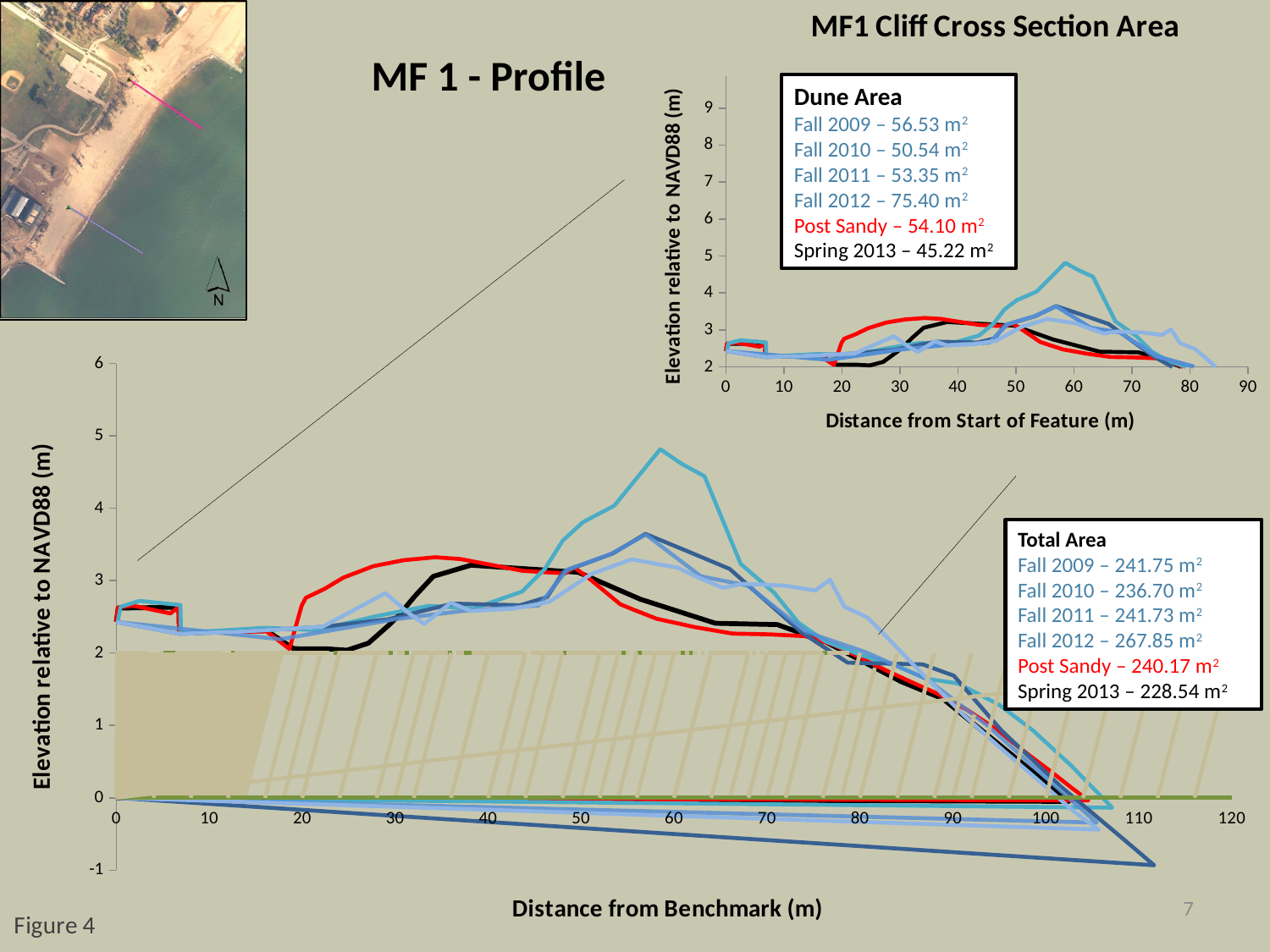
In the Dune Area box on the MF1 Cliff Cross Section Area chart, what is the value for Fall 2012? 75.40 m² In the Dune Area box on the MF1 Cliff Cross Section Area chart, what is the difference between the Fall 2012 and Spring 2013 values? 30.18 m² How many surveys are listed in the Total Area box on the MF 1 - Profile chart? 6 In the Dune Area box on the MF1 Cliff Cross Section Area chart, which survey has the largest area? Fall 2012 What kind of chart is the MF 1 - Profile chart? line chart In the Total Area box on the MF 1 - Profile chart, what is the value for Post Sandy? 240.17 m² In the Dune Area box on the MF1 Cliff Cross Section Area chart, which survey has the smallest area? Spring 2013 In the Total Area box on the MF 1 - Profile chart, which survey has the smallest area? Spring 2013 What is the x-axis title of the MF1 Cliff Cross Section Area chart? Distance from Start of Feature (m) On the MF 1 - Profile chart, is the highest elevation reached by any line greater or less than 4? greater What is the x-axis title of the MF 1 - Profile chart? Distance from Benchmark (m) In the Total Area box on the MF 1 - Profile chart, which is larger: Post Sandy or Fall 2010? Post Sandy